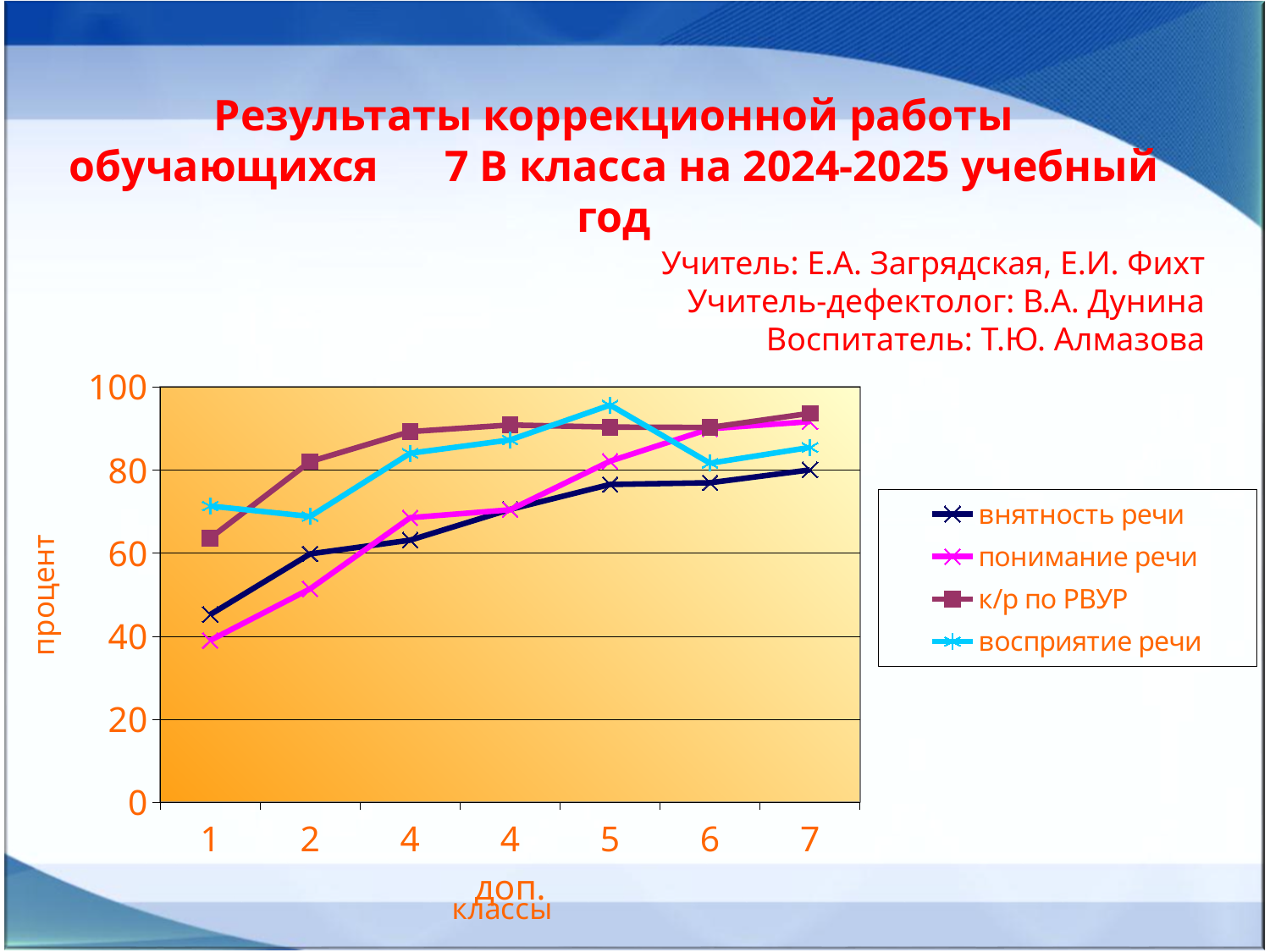
Is the value for внятность речи at x-axis label 1 greater or less than 40? greater How many points are plotted along the x axis for each series? 7 At x-axis label 2, which is larger: восприятие речи or понимание речи? восприятие речи At x-axis label 1, which series has the highest value? восприятие речи What is the title of the vertical axis? процент Is the value for восприятие речи at x-axis label 5 greater or less than 80? greater At x-axis label 1, which series has the lowest value? понимание речи Is the value for к/р по РВУР at x-axis label 1 greater or less than 80? less Does the внятность речи line rise or fall from left to right along the x axis? rises What kind of chart is shown on the slide? line chart How many series does the legend list? 4